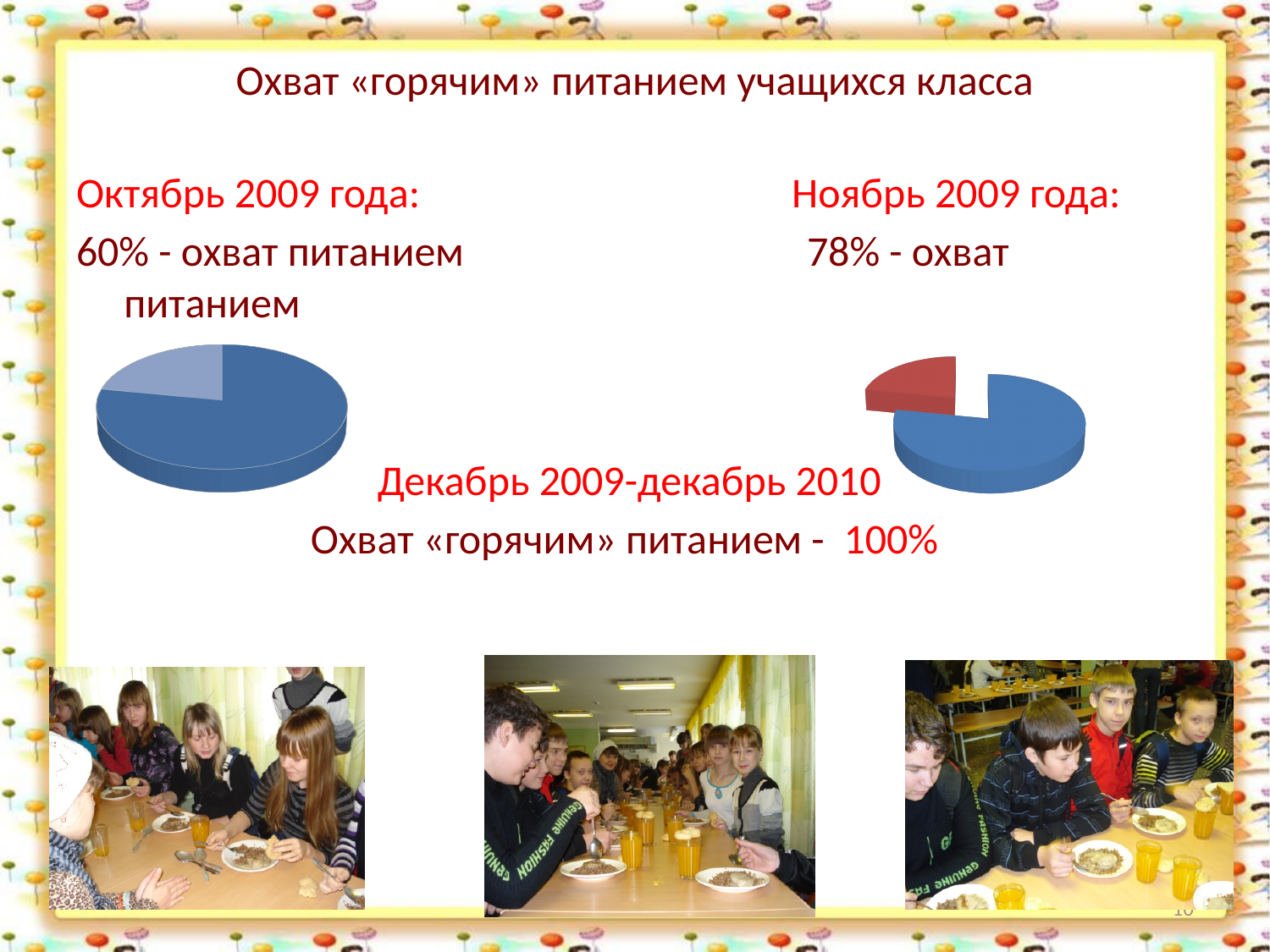
How many pie charts are on the slide? 2 How many slices does the right pie chart have? 2 What kind of chart is shown on the left of the slide? pie chart In the right pie chart, which slice is larger, the blue one or the red one? blue According to the slide text, what share of students was covered by hot meals in November 2009 (the right pie chart)? 78% In the left pie chart, which slice is the smallest? the light blue slice What colour is the pulled-out slice in the right pie chart? red In the left pie chart, which slice is larger, the dark blue one or the light blue one? dark blue How many slices does the left pie chart have? 2 In the right pie chart, which slice is the smallest? the red slice According to the slide text, what share of students was covered by hot meals in October 2009 (the left pie chart)? 60% What kind of chart is shown on the right of the slide? pie chart